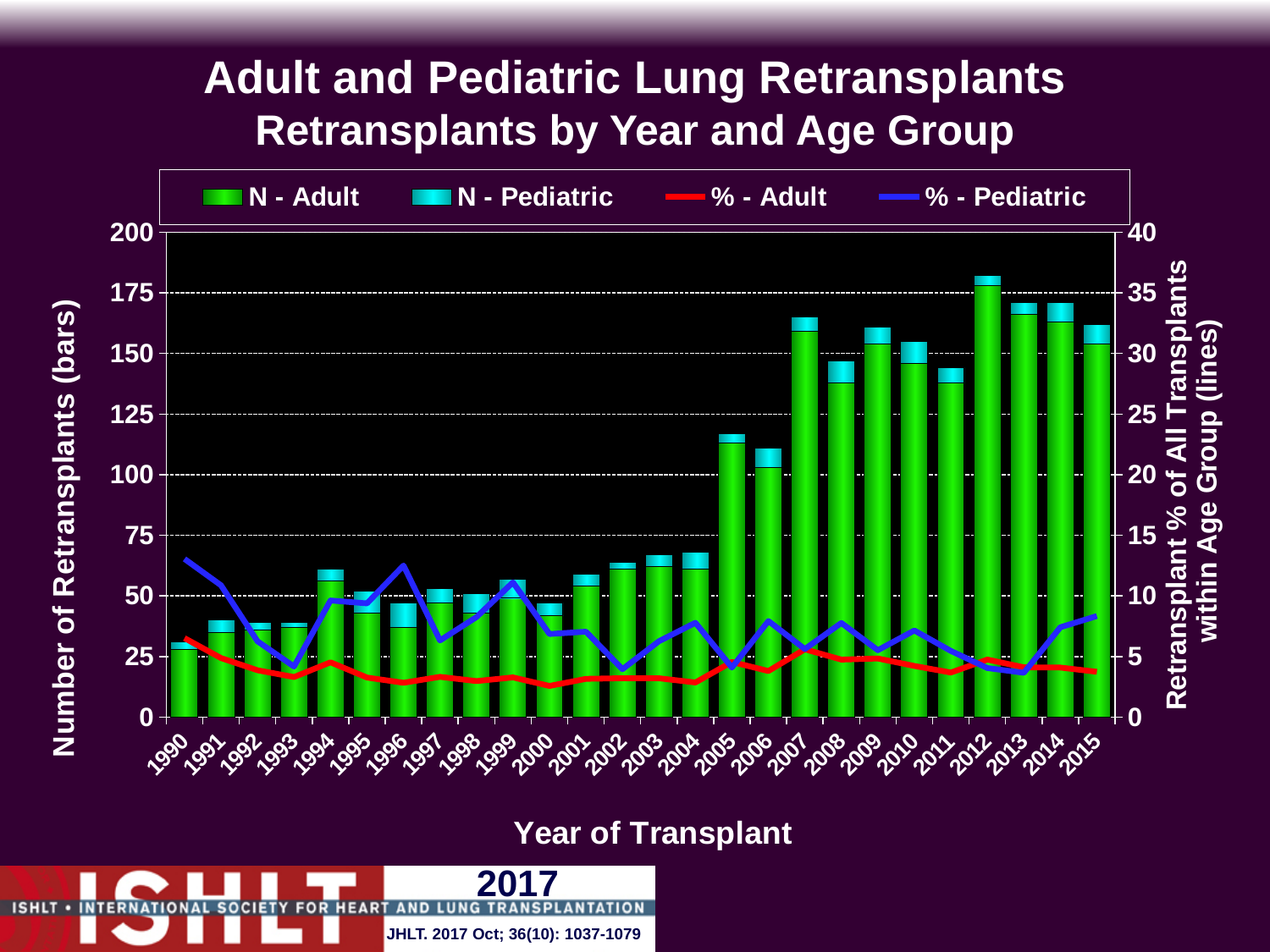
Is the total number of retransplants in 2011 greater or less than 150? less Which year has the tallest bar for number of retransplants? 2012 How many series does the legend list? 4 Which year has a taller bar, 2007 or 2008? 2007 Is the total number of retransplants in 1993 greater or less than 50? less What is the label of the right-hand vertical axis? Retransplant % of All Transplants within Age Group (lines) Is the total number of retransplants in 2005 greater or less than 100? greater How many years are shown along the x axis? 26 Which year has the shortest bar for number of retransplants? 1990 Does the % - Pediatric line rise or fall from 1990 to 1993? Fall What kind of chart is shown on the slide? A bar chart with line series (combination chart)